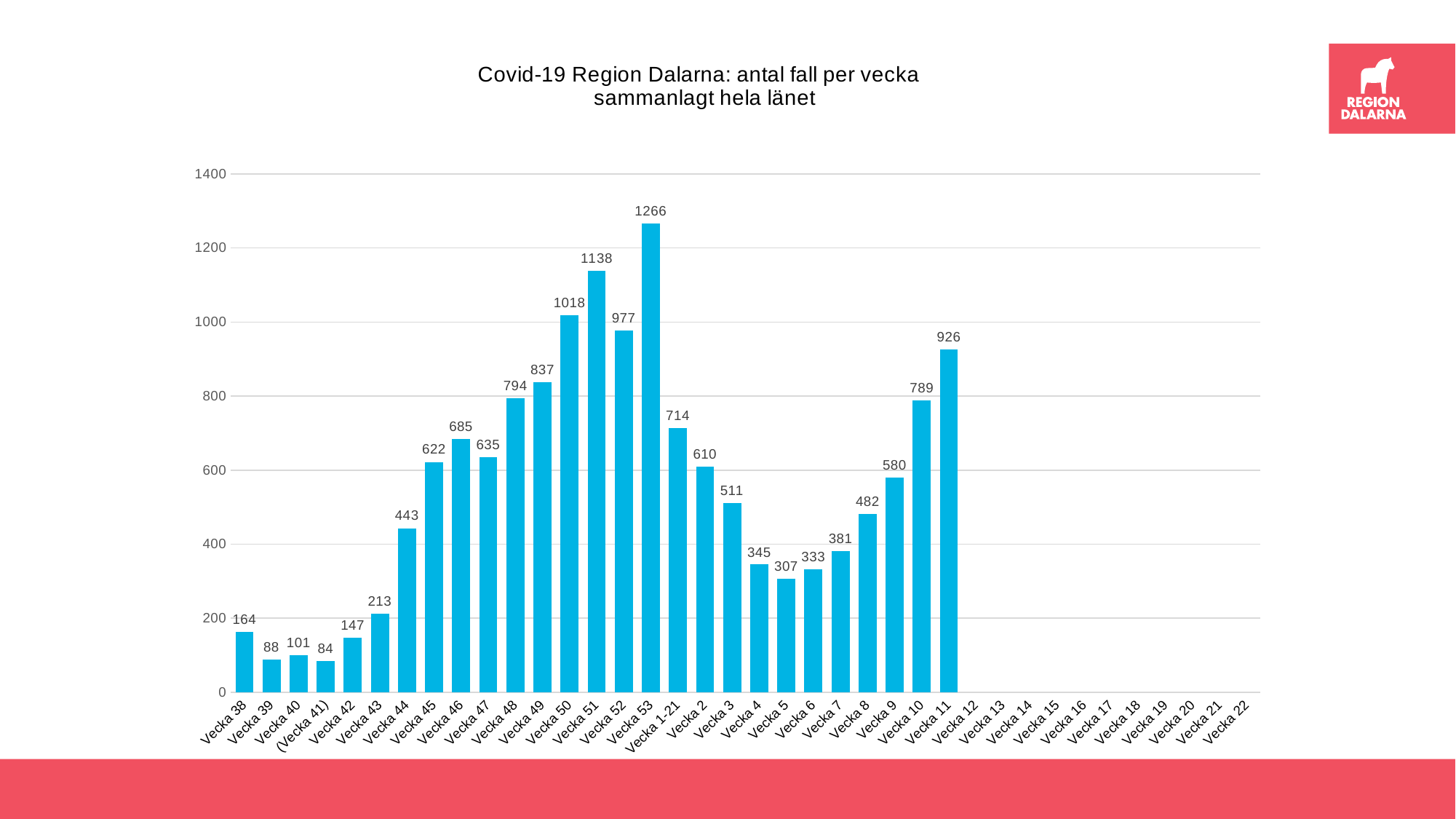
What is the value for Vecka 1-21? 714 What kind of chart is shown on the slide? bar chart What is the value for Vecka 53? 1266 Do the values rise or fall from Vecka 5 to Vecka 11? rise Which week has the highest number of cases? Vecka 53 Which is larger, the value for Vecka 52 or the value for Vecka 11? Vecka 52 What is the title of the chart? Covid-19 Region Dalarna: antal fall per vecka sammanlagt hela länet Which week has the lowest number of cases? (Vecka 41) How many weeks have a bar with a value plotted? 27 Is the value for Vecka 44 greater or less than 400? greater What is the difference between the values for Vecka 11 and Vecka 10? 137 What is the difference between the values for Vecka 51 and Vecka 50? 120